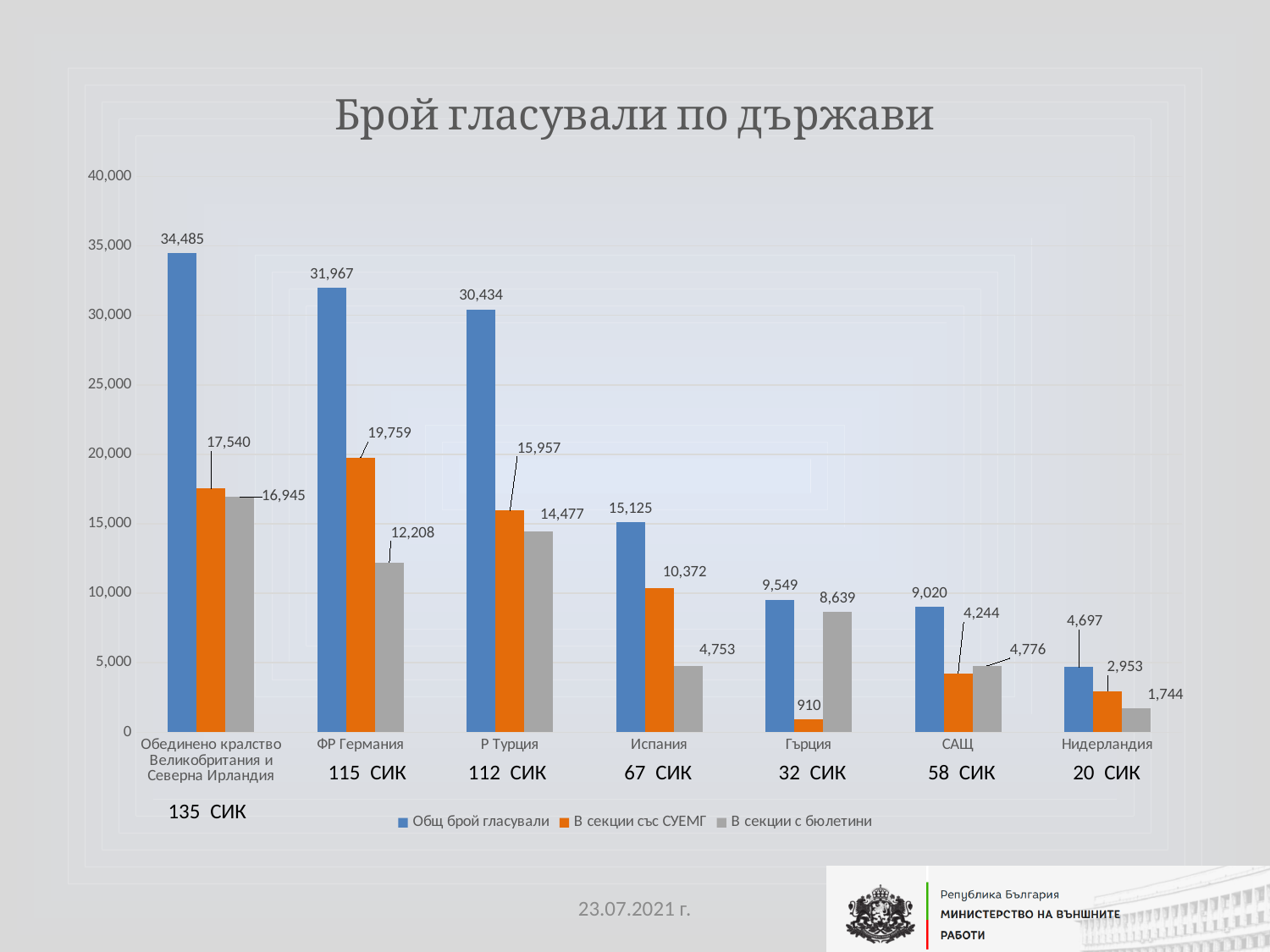
What is the difference between 'В секции със СУЕМГ' and 'В секции с бюлетини' for Испания? 5,619 Which country has the highest value for 'Общ брой гласували'? Обединено кралство Великобритания и Северна Ирландия How many series does the legend list? 3 How many countries (categories) are shown on the x axis? 7 What type of chart is shown on the slide? bar chart For САЩ, which is larger: 'В секции със СУЕМГ' or 'В секции с бюлетини'? В секции с бюлетини Do the 'Общ брой гласували' values rise or fall from left to right along the x axis? fall Which country has the lowest value for 'В секции с бюлетини'? Нидерландия What is the value of 'В секции с бюлетини' for Р Турция? 14,477 What is the value of 'В секции със СУЕМГ' for Гърция? 910 What is the title of the chart? Брой гласували по държави What is the value of 'Общ брой гласували' for ФР Германия? 31,967